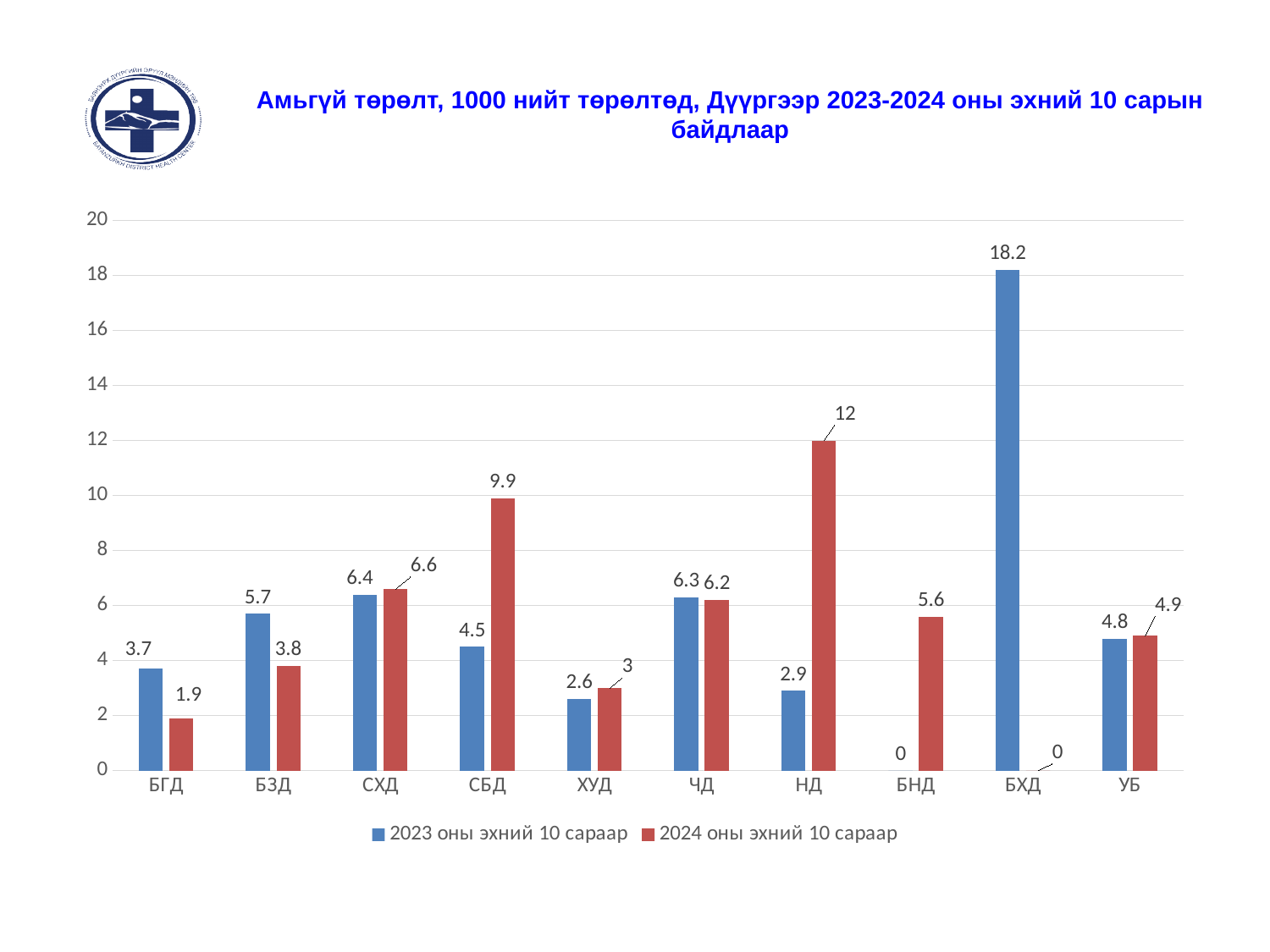
Is the value for БХД in the 2023 оны эхний 10 сараар series greater or less than 16? greater What is the value for БХД in the 2023 оны эхний 10 сараар series? 18.2 What is the value for НД in the 2024 оны эхний 10 сараар series? 12 How many series does the legend list? 2 What is the difference between the 2024 and 2023 values for НД? 9.1 Which category has the lowest value in the 2024 оны эхний 10 сараар series? БХД For СБД, which series has the larger value: 2023 оны эхний 10 сараар or 2024 оны эхний 10 сараар? 2024 оны эхний 10 сараар What is the value for СБД in the 2024 оны эхний 10 сараар series? 9.9 What kind of chart is shown on the slide? Bar chart What colour are the bars for the 2024 оны эхний 10 сараар series? Red How many categories are shown on the x axis? 10 Which category has the highest value in the 2023 оны эхний 10 сараар series? БХД